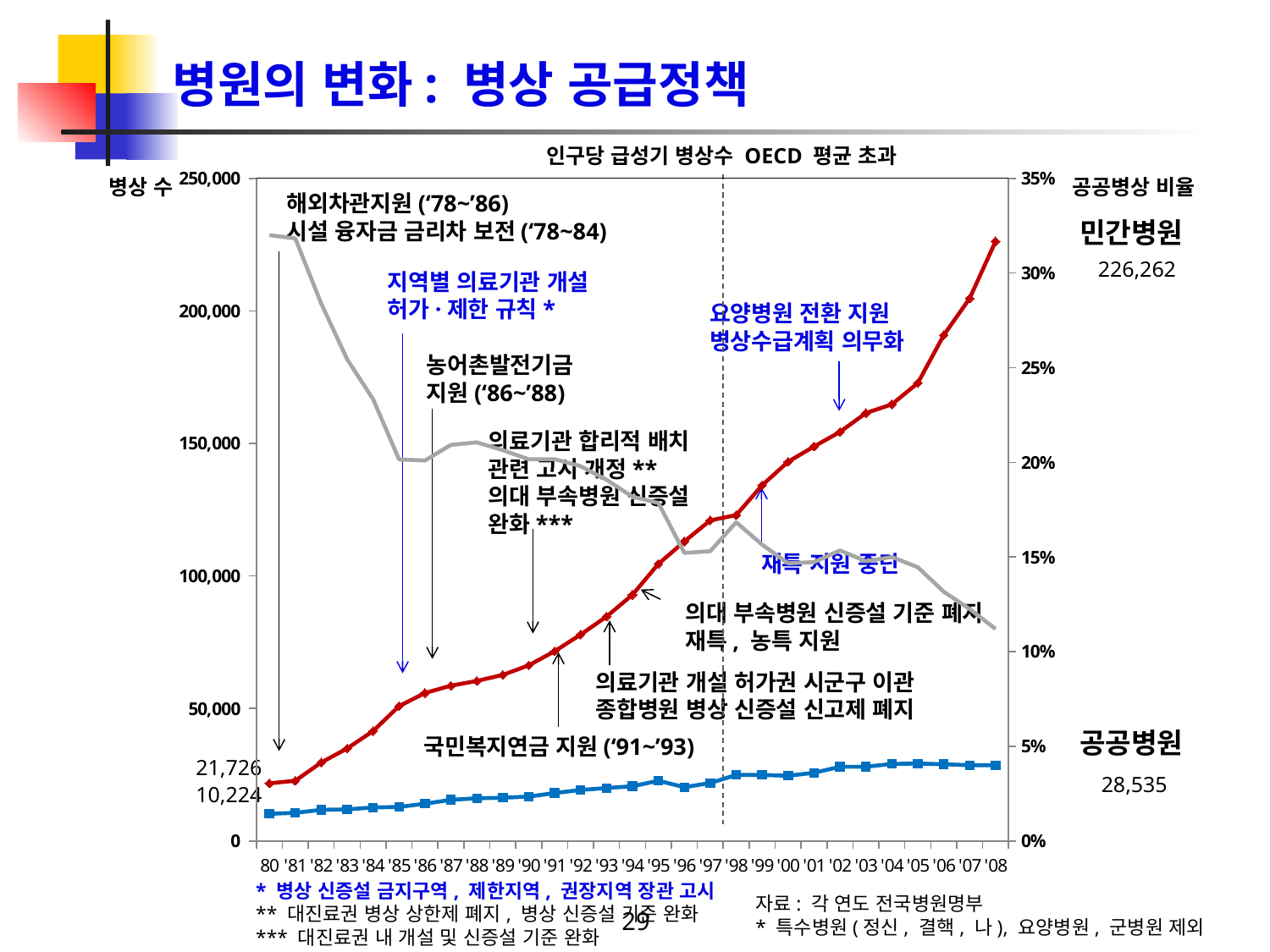
What is the value for 민간병원 in '80? 21,726 Which is larger in '08, 민간병원 or 공공병원? 민간병원 What kind of chart is shown on the slide? line chart What is the value for 공공병원 in '80? 10,224 What is the label of the left vertical axis? 병상 수 By how much did 민간병원 increase from '80 to '08? 204,536 What is the value for 공공병원 in '08? 28,535 Does the 민간병원 line rise or fall from '80 to '08? rise What is the value for 민간병원 in '08? 226,262 By how much did 공공병원 increase from '80 to '08? 18,311 Is the value for 민간병원 in '00 greater or less than 100,000? greater What is the difference between 민간병원 and 공공병원 in '08? 197,727